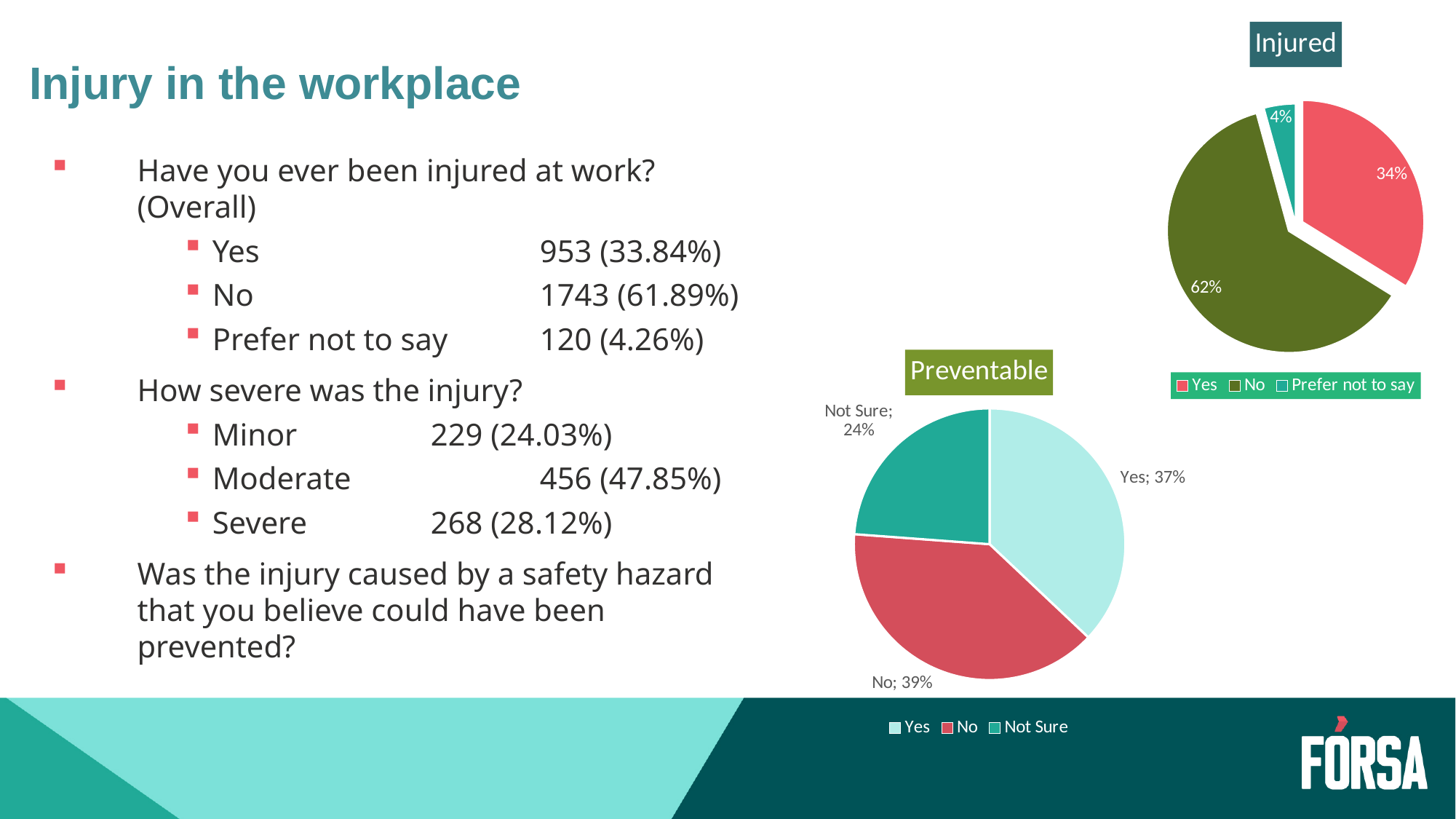
In the 'Injured' pie chart, what is the difference in percentage points between 'No' and 'Yes'? 28 What type of chart is the 'Injured' chart? Pie chart In the 'Injured' pie chart, what percentage is shown for 'Yes'? 34% How many slices does the 'Preventable' pie chart have? 3 In the 'Injured' pie chart, what percentage is shown for 'No'? 62% In the 'Preventable' pie chart, what percentage is shown for 'No'? 39% In the 'Injured' pie chart, what percentage is shown for 'Prefer not to say'? 4% In the 'Injured' pie chart, which category has the smallest slice? Prefer not to say In the 'Preventable' pie chart, which category has the smallest slice? Not Sure In the 'Injured' pie chart, which category has the largest slice? No In the 'Preventable' pie chart, what is the difference in percentage points between 'Yes' and 'Not Sure'? 13 In the 'Preventable' pie chart, what percentage is shown for 'Not Sure'? 24%